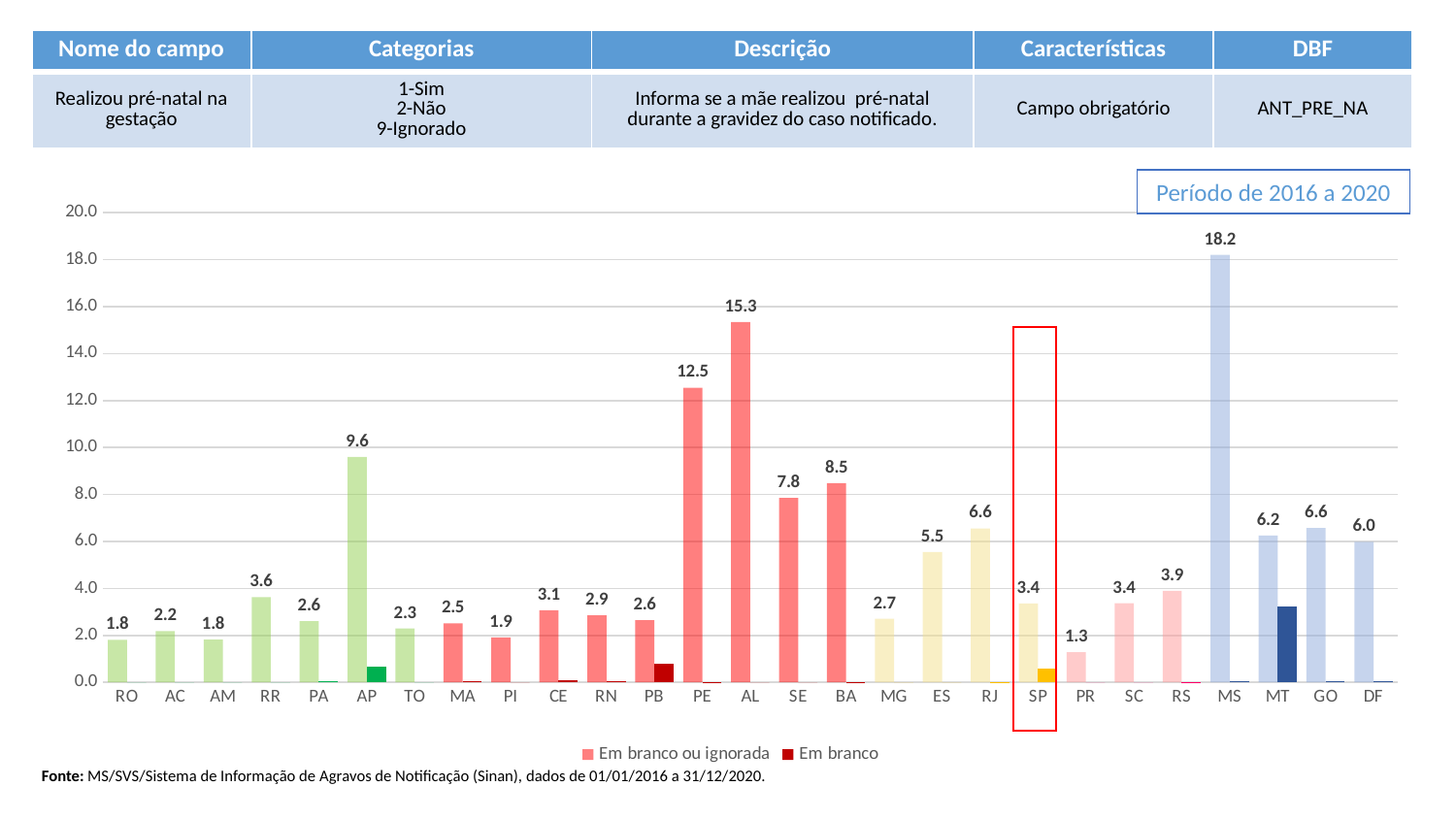
What is the 'Em branco ou ignorada' value for MS? 18.2 What is the 'Em branco ou ignorada' value for SP? 3.4 How many series does the chart legend list? 2 How many states are shown on the x axis of the chart? 27 Which state has the lowest 'Em branco ou ignorada' value? PR What period does the chart cover, according to the box at the top right? Período de 2016 a 2020 What is the 'Em branco ou ignorada' value for AL? 15.3 Is the 'Em branco' value for MT greater or less than 2.0? greater What is the difference between the 'Em branco ou ignorada' values for PE and AP? 2.9 Which state has the highest 'Em branco ou ignorada' value? MS What kind of chart is shown on the slide? bar chart Which has a larger 'Em branco ou ignorada' value, BA or SE? BA